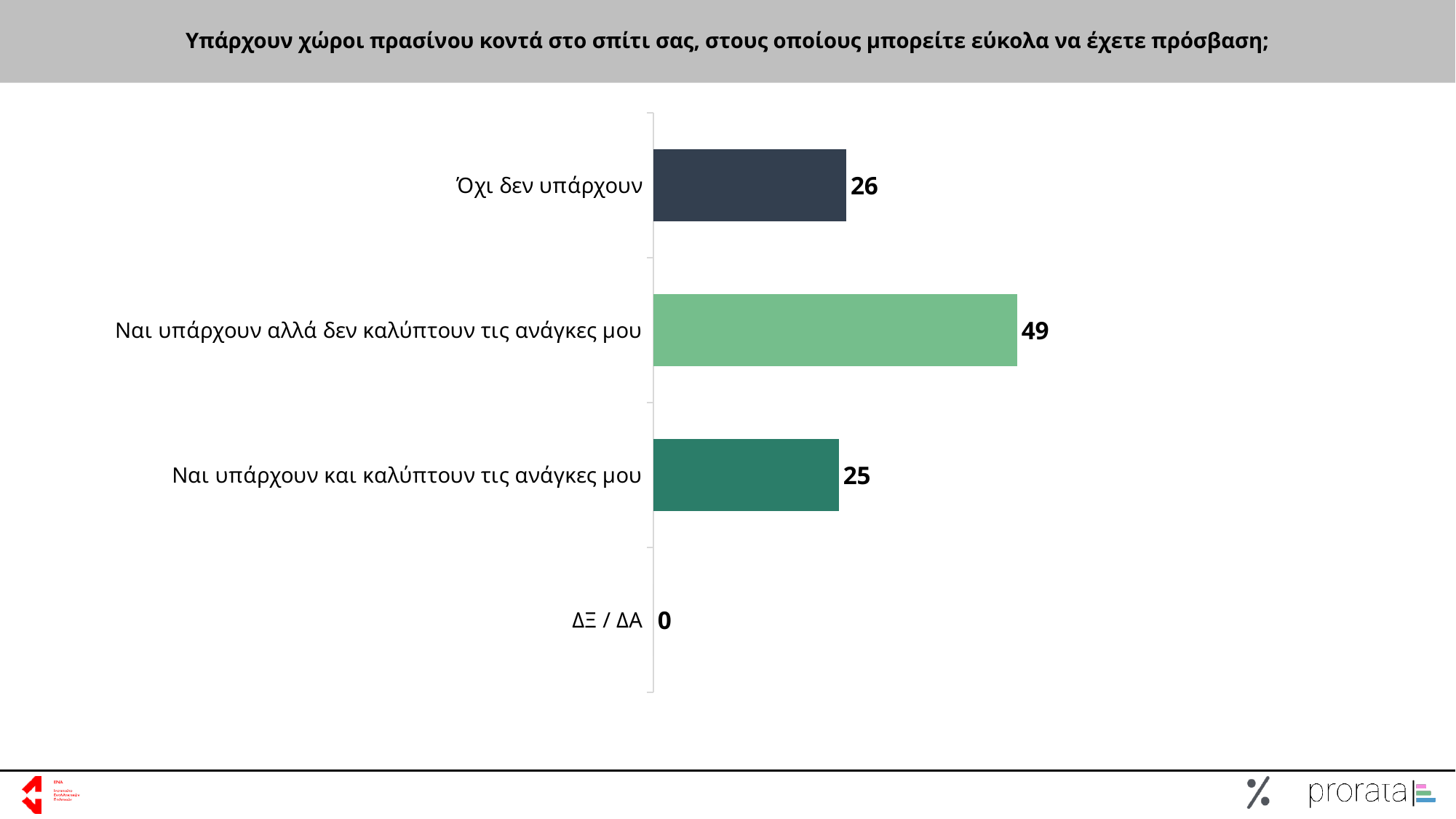
What is the value for "Ναι υπάρχουν αλλά δεν καλύπτουν τις ανάγκες μου"? 49 Which is larger: the value for "Ναι υπάρχουν αλλά δεν καλύπτουν τις ανάγκες μου" or the value for "Ναι υπάρχουν και καλύπτουν τις ανάγκες μου"? Ναι υπάρχουν αλλά δεν καλύπτουν τις ανάγκες μου How many categories are shown in the chart? 4 What kind of chart is shown on the slide? Bar chart What is the difference between the values for "Ναι υπάρχουν αλλά δεν καλύπτουν τις ανάγκες μου" and "Όχι δεν υπάρχουν"? 23 What is the difference between the values for "Όχι δεν υπάρχουν" and "Ναι υπάρχουν και καλύπτουν τις ανάγκες μου"? 1 What is the value for "Ναι υπάρχουν και καλύπτουν τις ανάγκες μου"? 25 What is the value for "ΔΞ / ΔΑ"? 0 Which category has the lowest value? ΔΞ / ΔΑ Which category has the highest value? Ναι υπάρχουν αλλά δεν καλύπτουν τις ανάγκες μου What is the value for "Όχι δεν υπάρχουν"? 26 What is the title of the chart? Υπάρχουν χώροι πρασίνου κοντά στο σπίτι σας, στους οποίους μπορείτε εύκολα να έχετε πρόσβαση;